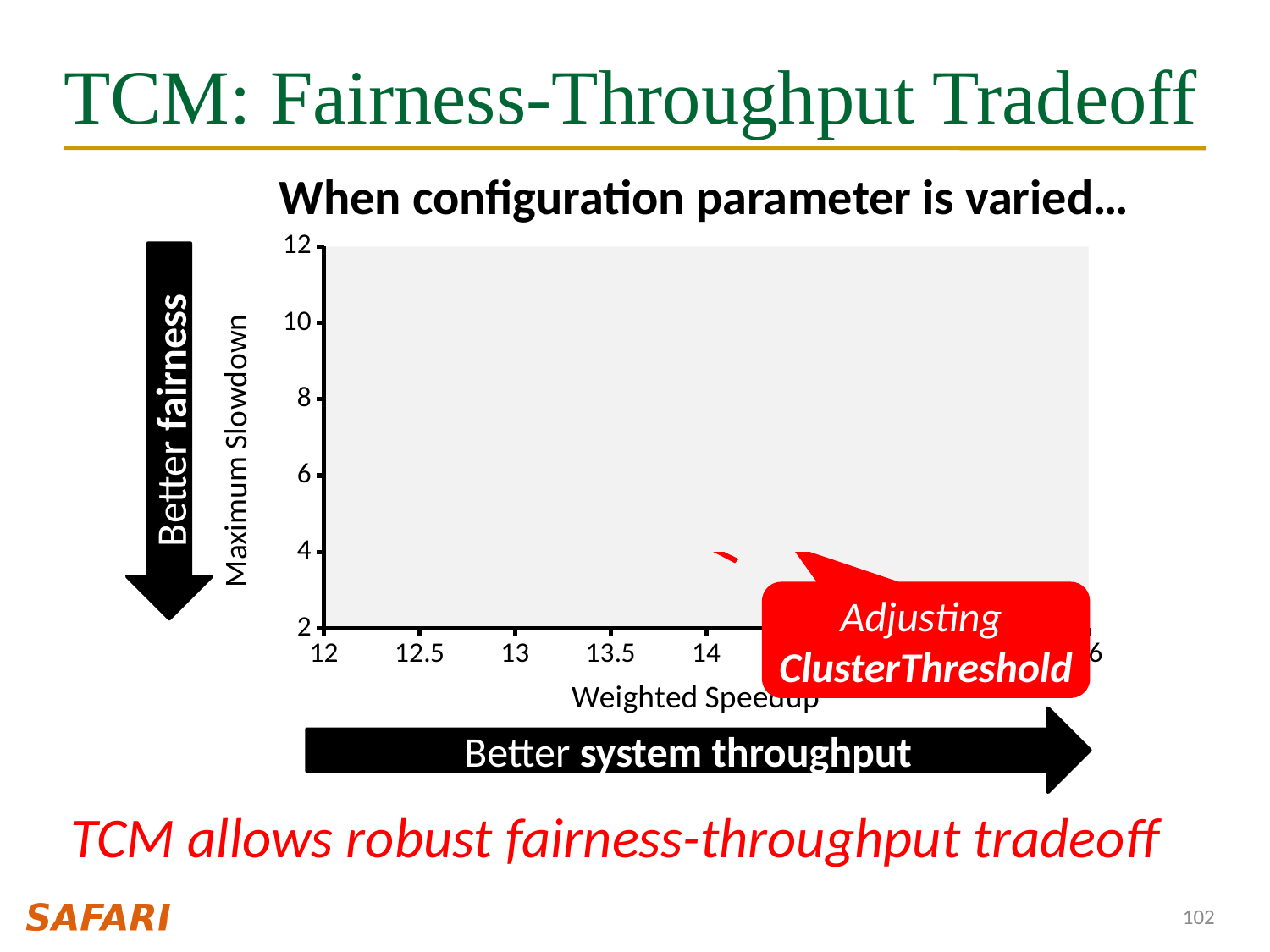
Is the Weighted Speedup of the visible red data point greater or less than 12.5? greater Is the Weighted Speedup of the visible red data point greater or less than 13? greater What is the title of the y axis of the chart? Maximum Slowdown What is the title of the x axis of the chart? Weighted Speedup Is the Maximum Slowdown of the visible red data point greater or less than 6? less